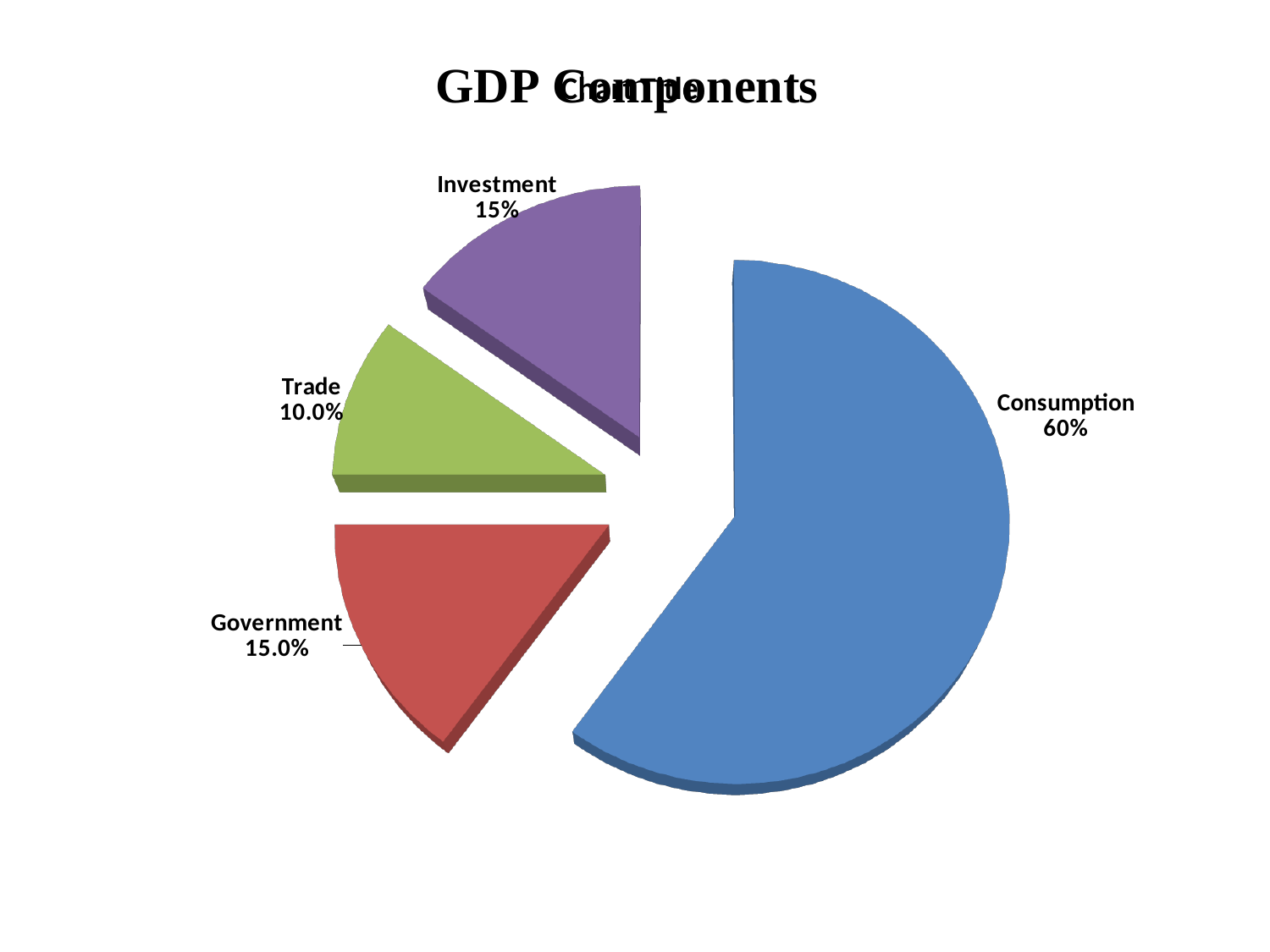
What is the value shown for the Investment slice? 15% What kind of chart is shown on the slide? Pie chart What percentage of GDP does Consumption account for in the pie chart? 60% Which component has the smallest slice of the pie? Trade What is the value shown for the Trade slice? 10.0% Which component is shown by the blue slice? Consumption How many slices does the pie chart have? 4 By how many percentage points does Consumption exceed Trade? 50 percentage points Which is larger, the Consumption slice or the Government slice? Consumption What share of the pie does the Consumption slice represent? 60% What is the value shown for the Government slice? 15.0% Which component has the largest slice of the pie? Consumption